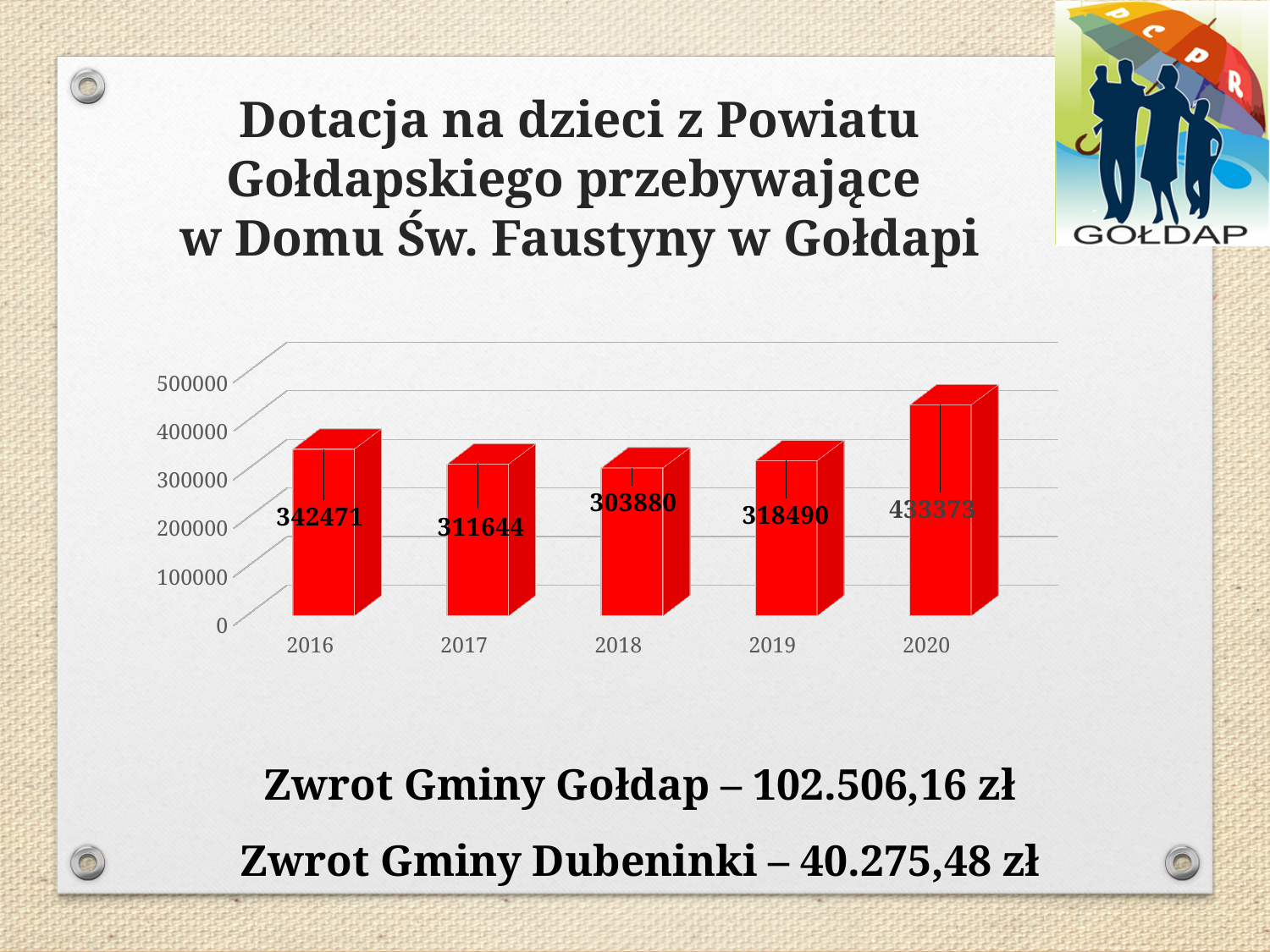
What colour are the bars in the chart? red Which year has the lowest value? 2018 What is the value for 2020? 433373 Which is larger, the value for 2016 or the value for 2019? 2016 Which year has the highest value? 2020 What is the value for 2016? 342471 What is the difference between the values for 2020 and 2019? 114883 What is the value for 2018? 303880 How many years are shown on the x axis? 5 Is the value for 2020 greater or less than 400000? greater What is the difference between the values for 2016 and 2017? 30827 What kind of chart is shown on the slide? bar chart